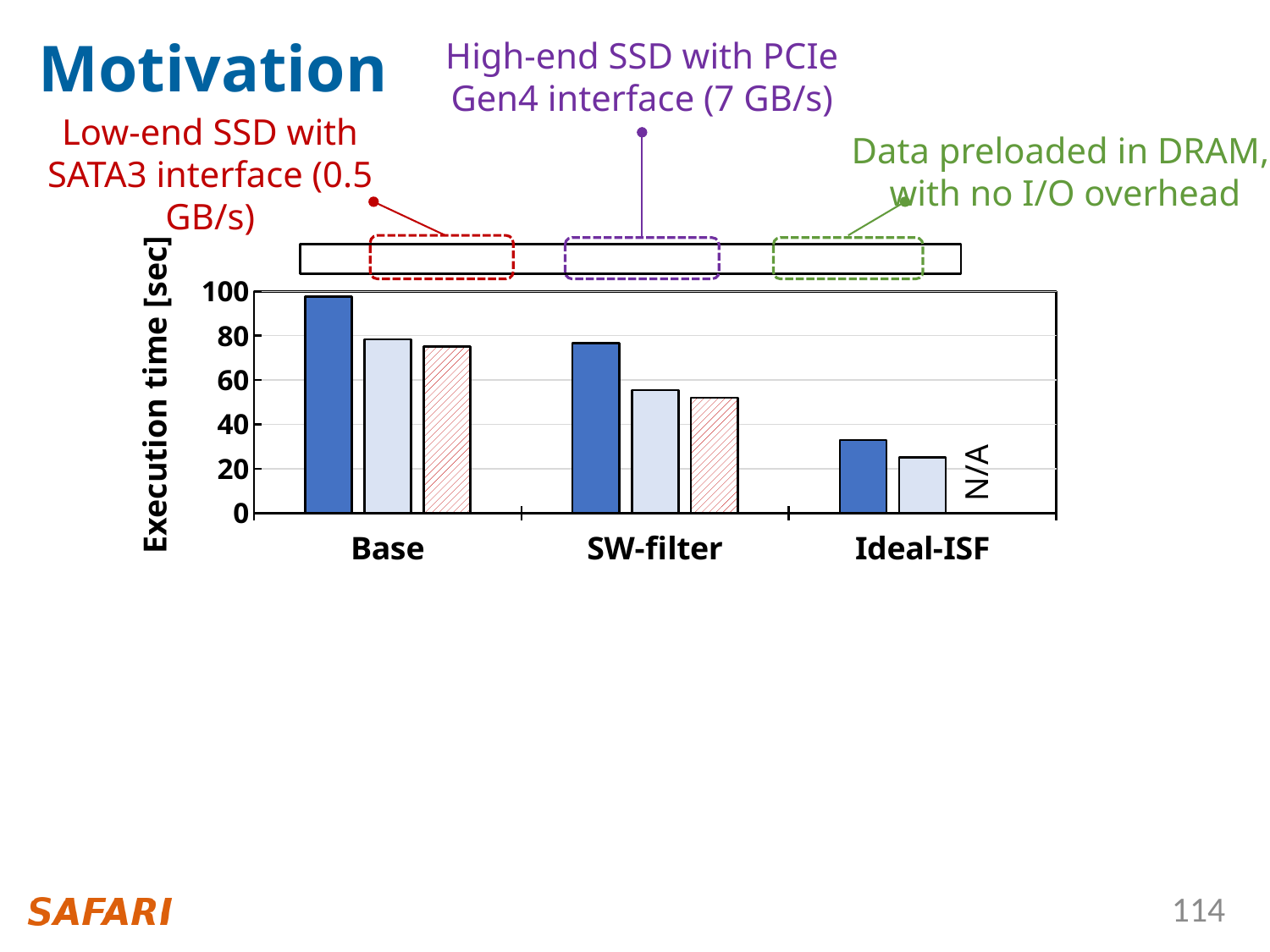
Do the dark blue (first) bars rise or fall moving from Base to Ideal-ISF along the x axis? fall Is the value of the dark blue (first) bar for Ideal-ISF greater or less than 40? less How many categories are shown on the x axis of the chart? 3 Is the value of the dark blue (first) bar for SW-filter greater or less than 60? greater What kind of chart is shown on the slide? bar chart Which category has the lowest bars in the chart? Ideal-ISF Which is larger: the dark blue (first) bar for Base or the dark blue (first) bar for SW-filter? Base What text is shown in place of the third bar for Ideal-ISF? N/A Which category has the tallest bar in the chart? Base What is the label of the y axis of the chart? Execution time [sec] Is the value of the red hatched (third) bar for SW-filter greater or less than 60? less